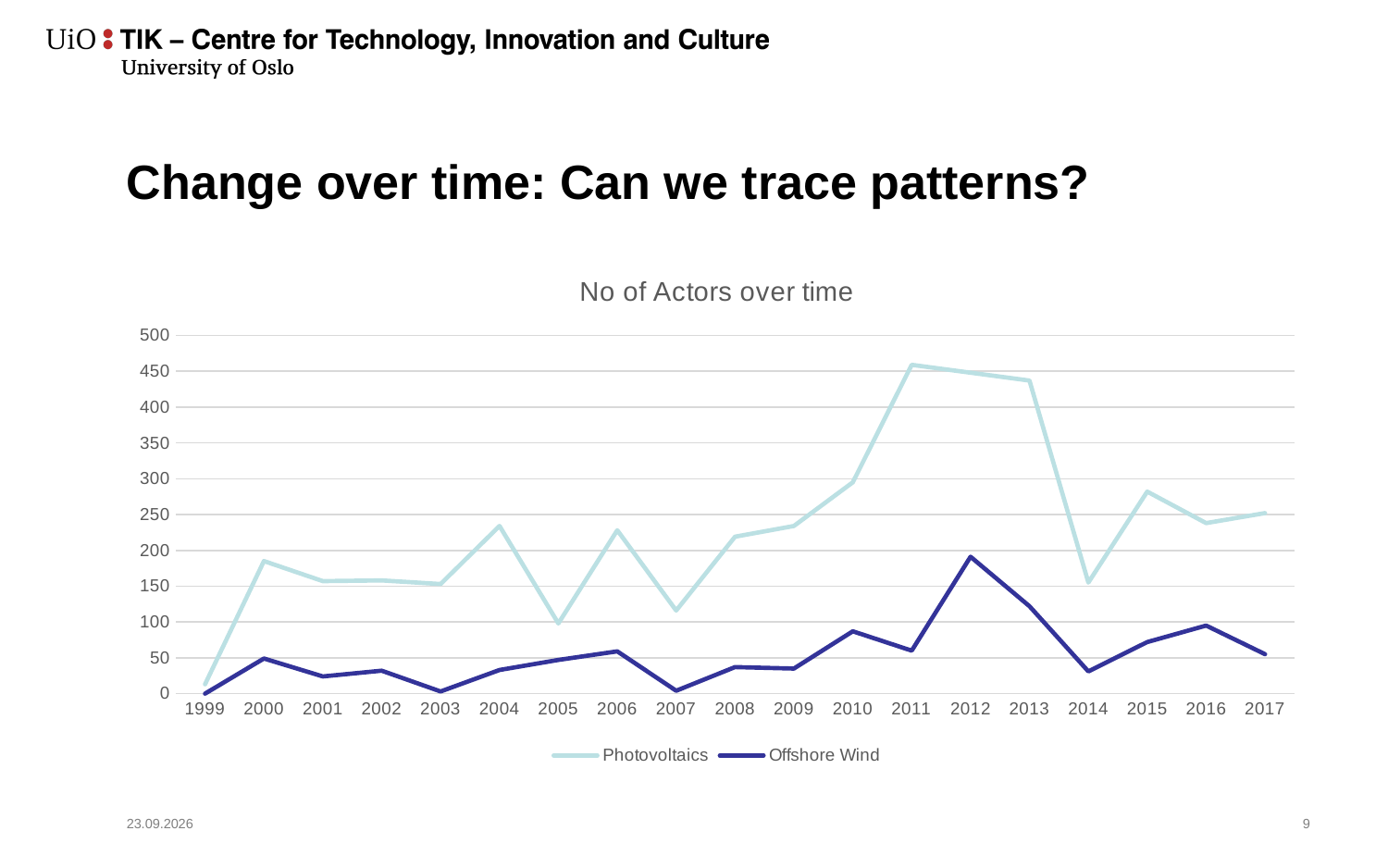
Is the value for Photovoltaics in 2014 greater or less than 200? less How many series does the legend list? 2 What is the title of the chart? No of Actors over time Is the value for Photovoltaics in 2011 greater or less than 400? greater In which year does the Offshore Wind series reach its highest value? 2012 Which series has the larger value in 2011, Photovoltaics or Offshore Wind? Photovoltaics In which year is the Photovoltaics series at its lowest value? 1999 In which year does the Photovoltaics series reach its highest value? 2011 Is the value for Offshore Wind in 2012 greater or less than 150? greater Does the Photovoltaics series rise or fall from 2013 to 2014? fall What kind of chart is shown on the slide? line chart How many years are shown on the x axis? 19